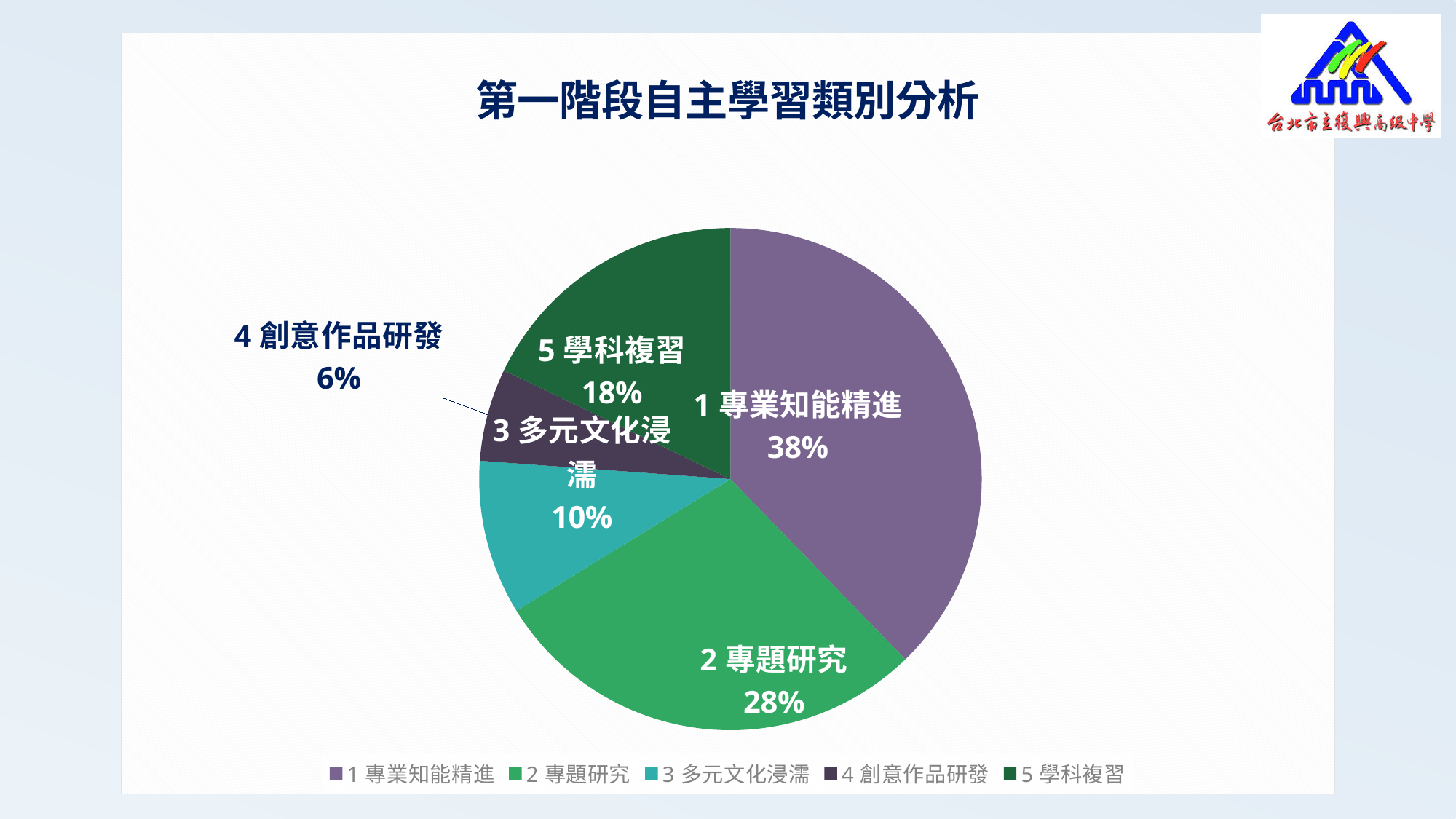
What type of chart is shown on the slide? pie chart What percentage share does 3 多元文化浸濡 have? 10% What is the difference in percentage points between 1 專業知能精進 and 2 專題研究? 10 Which category has the largest share of the pie? 1 專業知能精進 What percentage share does 5 學科複習 have? 18% What percentage share does 4 創意作品研發 have? 6% What is the title of the chart? 第一階段自主學習類別分析 How many categories does the pie chart have? 5 Which has a larger share, 5 學科複習 or 3 多元文化浸濡? 5 學科複習 What percentage share does 2 專題研究 have? 28% What percentage share does 1 專業知能精進 have? 38% Which category has the smallest share of the pie? 4 創意作品研發